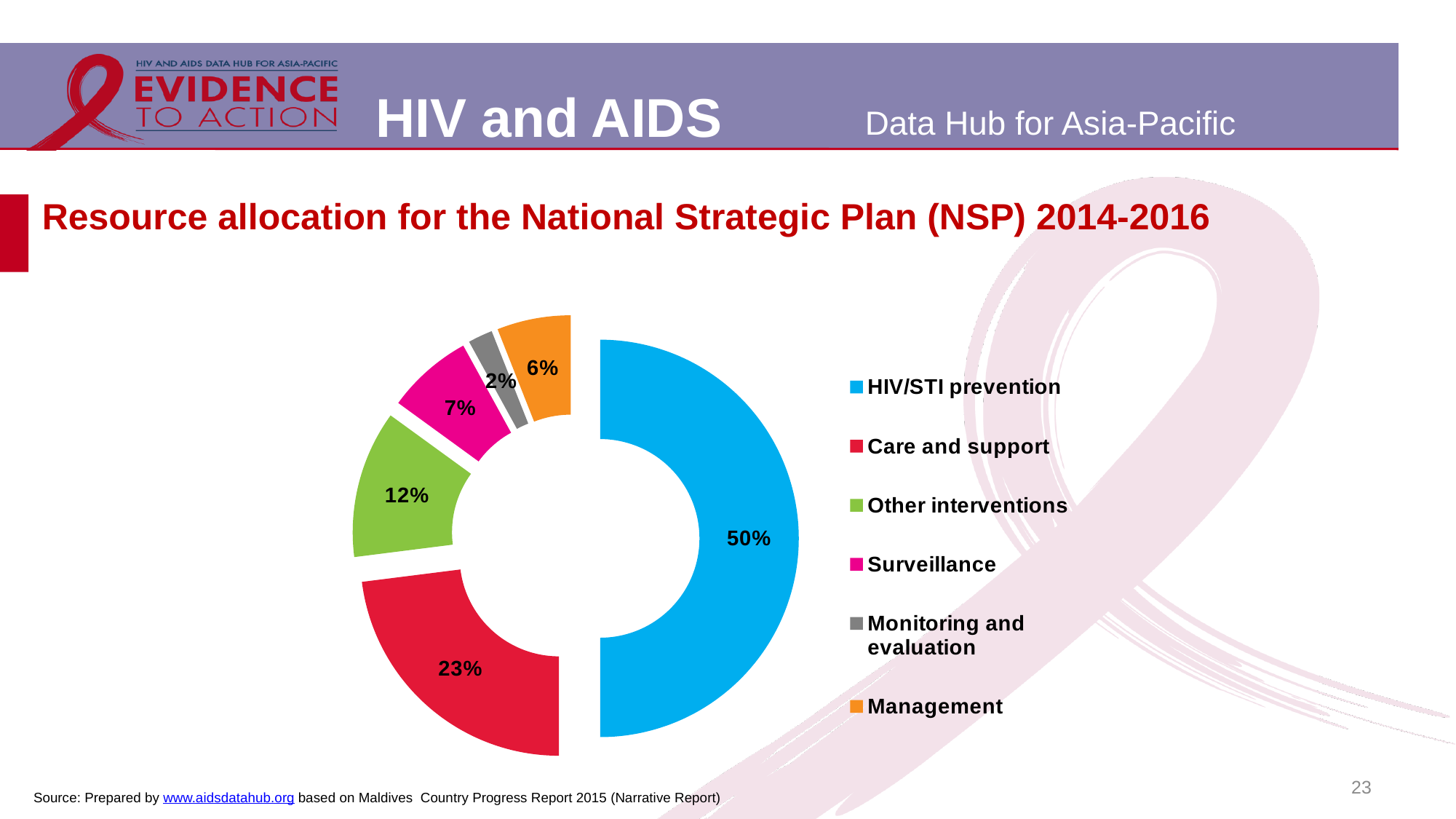
Which category receives the smallest share of the resource allocation? Monitoring and evaluation What share of the NSP 2014-2016 resource allocation goes to HIV/STI prevention? 50% Which category receives the largest share of the resource allocation? HIV/STI prevention What share is allocated to Monitoring and evaluation? 2% What percentage of resources is allocated to Management? 6% What kind of chart is used to show the resource allocation? Pie chart (doughnut) How many percentage points larger is the HIV/STI prevention share than the Care and support share? 27 What percentage of resources is allocated to Care and support? 23% What share is allocated to Other interventions? 12% How many categories are shown in the chart? 6 Which receives a larger share: Surveillance or Management? Surveillance What percentage of the allocation goes to Surveillance? 7%